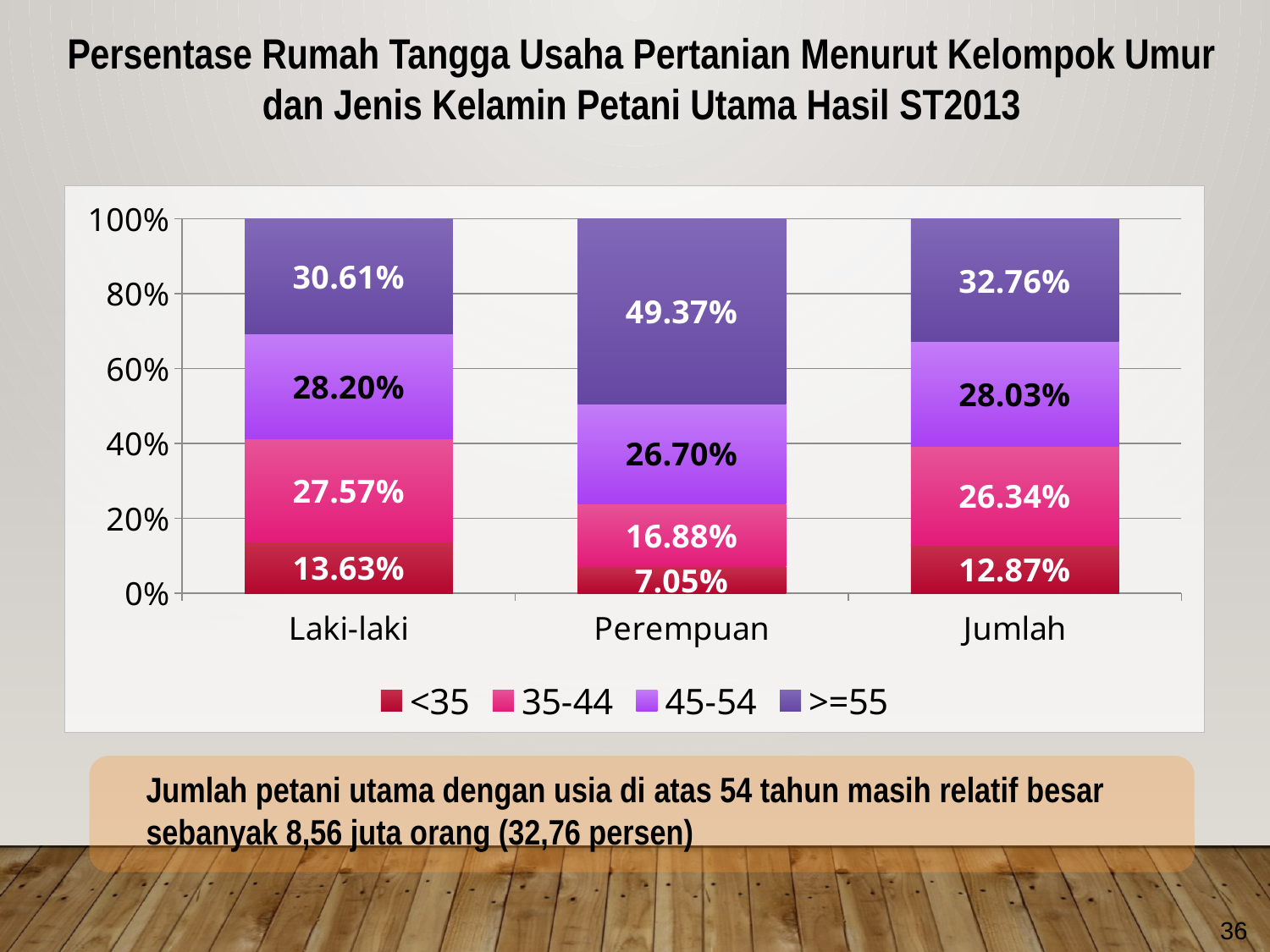
How many categories are shown on the x axis? 3 Which is larger: the 35-44 value for Laki-laki or the 35-44 value for Perempuan? Laki-laki What is the value for the >=55 age group in the Perempuan bar? 49.37% Which legend entry is shown in the darkest red colour? <35 Which category has the highest value for the >=55 age group? Perempuan How many series does the legend list? 4 What is the value for the 45-54 age group in the Perempuan bar? 26.70% What kind of chart is shown on the slide? Stacked bar chart What is the difference between the >=55 values for Perempuan and Laki-laki? 18.76% What is the value for the 35-44 age group in the Jumlah bar? 26.34% What is the value for the <35 age group in the Laki-laki bar? 13.63% Which category has the lowest value for the <35 age group? Perempuan